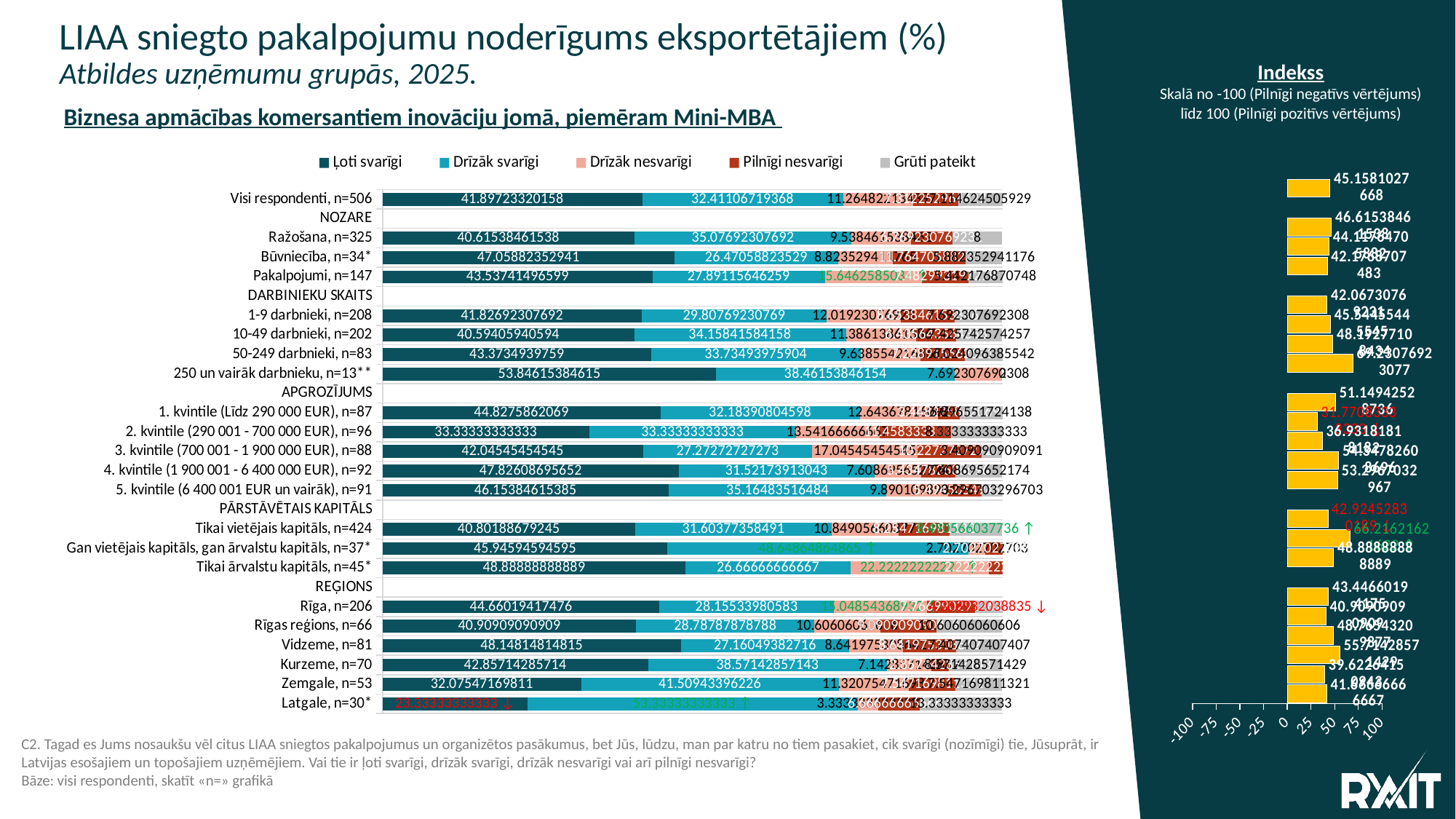
In the main chart, what is the difference between the 'Ļoti svarīgi' and 'Drīzāk svarīgi' values for '250 un vairāk darbinieku, n=13**'? 15.38461538461 In the main chart, which group has the lowest 'Ļoti svarīgi' value? Latgale, n=30* In the main chart, what is the 'Drīzāk svarīgi' value for 'Latgale, n=30*'? 53.33333333333 In the main chart, which group has the highest 'Ļoti svarīgi' value? 250 un vairāk darbnieku, n=13** How many series does the legend of the main chart list? 5 What kind of chart is the main chart on the slide? bar chart In the 'Indekss' chart on the right, what is the index value for 'Visi respondenti, n=506'? 45.1581027668 In the main chart, what is the 'Ļoti svarīgi' value for 'Visi respondenti, n=506'? 41.89723320158 In the main chart, how many groups are listed under the 'REĢIONS' section? 6 In the 'Indekss' chart on the right, is the index value for 'Visi respondenti, n=506' greater or less than 25? greater In the main chart, which has the larger 'Ļoti svarīgi' value: 'Vidzeme, n=81' or 'Kurzeme, n=70'? Vidzeme, n=81 In the main chart, what is the 'Drīzāk nesvarīgi' value for '3. kvintile (700 001 - 1 900 000 EUR), n=88'? 17.04545454545